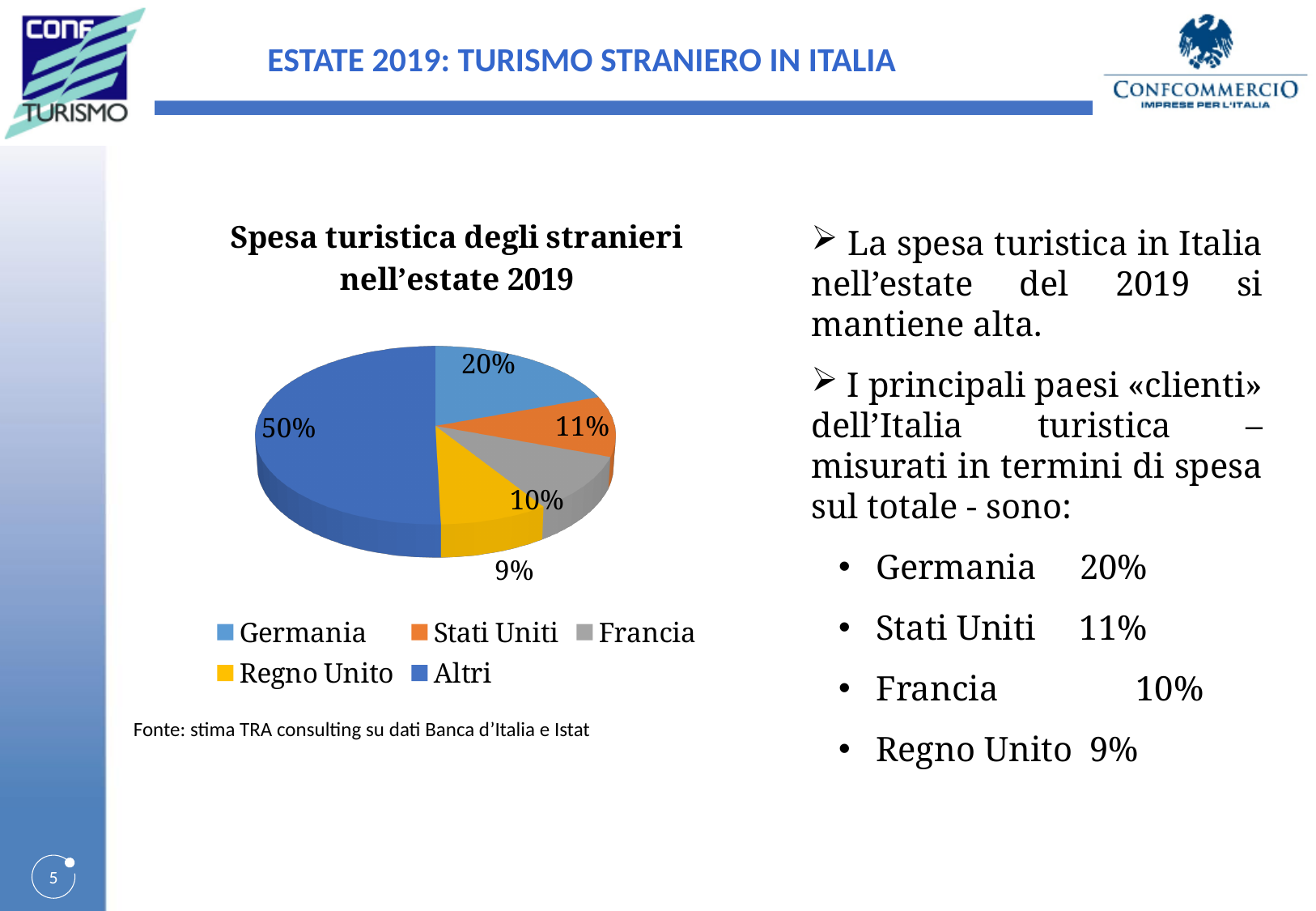
What share of the pie does Altri represent? 50% What is the title of the chart? Spesa turistica degli stranieri nell'estate 2019 Which category has the largest slice of the pie? Altri What share of the pie does Francia represent? 10% Which is larger, the share for Stati Uniti or the share for Francia? Stati Uniti What is the difference in percentage points between Germania and Regno Unito? 11 What kind of chart is shown on the slide? Pie chart What share of the pie does Regno Unito represent? 9% What share of the pie does Germania represent? 20% What share of the pie does Stati Uniti represent? 11% How many categories does the pie chart show? 5 Which category has the smallest slice of the pie? Regno Unito